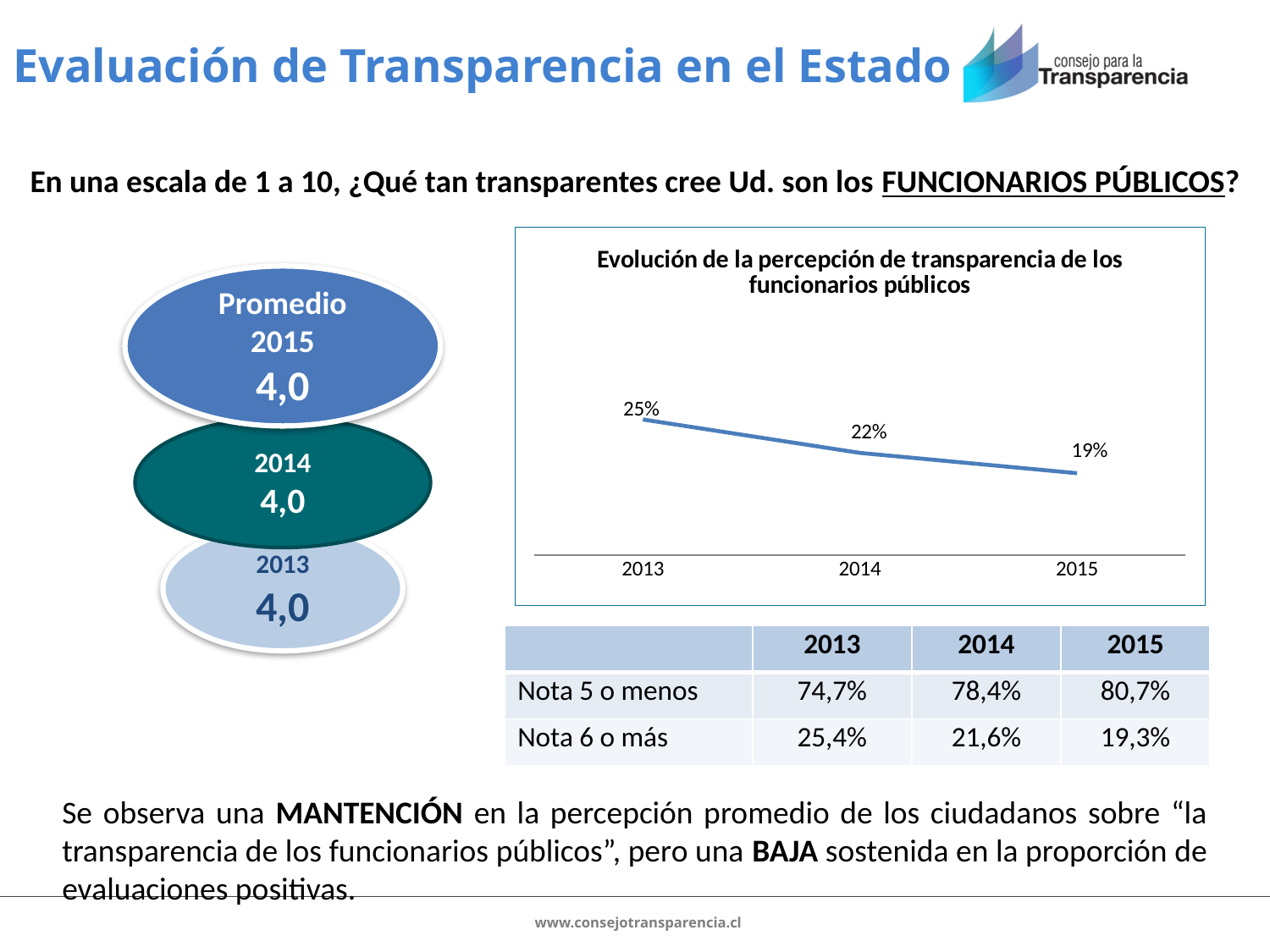
Which year has the lowest value in the line chart? 2015 What kind of chart is shown on the slide? Line chart What is the title of the line chart? Evolución de la percepción de transparencia de los funcionarios públicos How many data points are plotted in the line chart? 3 Which is larger in the line chart, the value for 2014 or the value for 2015? 2014 What is the value for 2013 in the line chart? 25% What is the value for 2015 in the line chart? 19% What is the value for 2014 in the line chart? 22% Which year has the highest value in the line chart? 2013 What is the difference between the 2013 and 2015 values in the line chart? 6% What is the difference between the 2013 and 2014 values in the line chart? 3% Do the values in the line chart rise or fall from 2013 to 2015? Fall